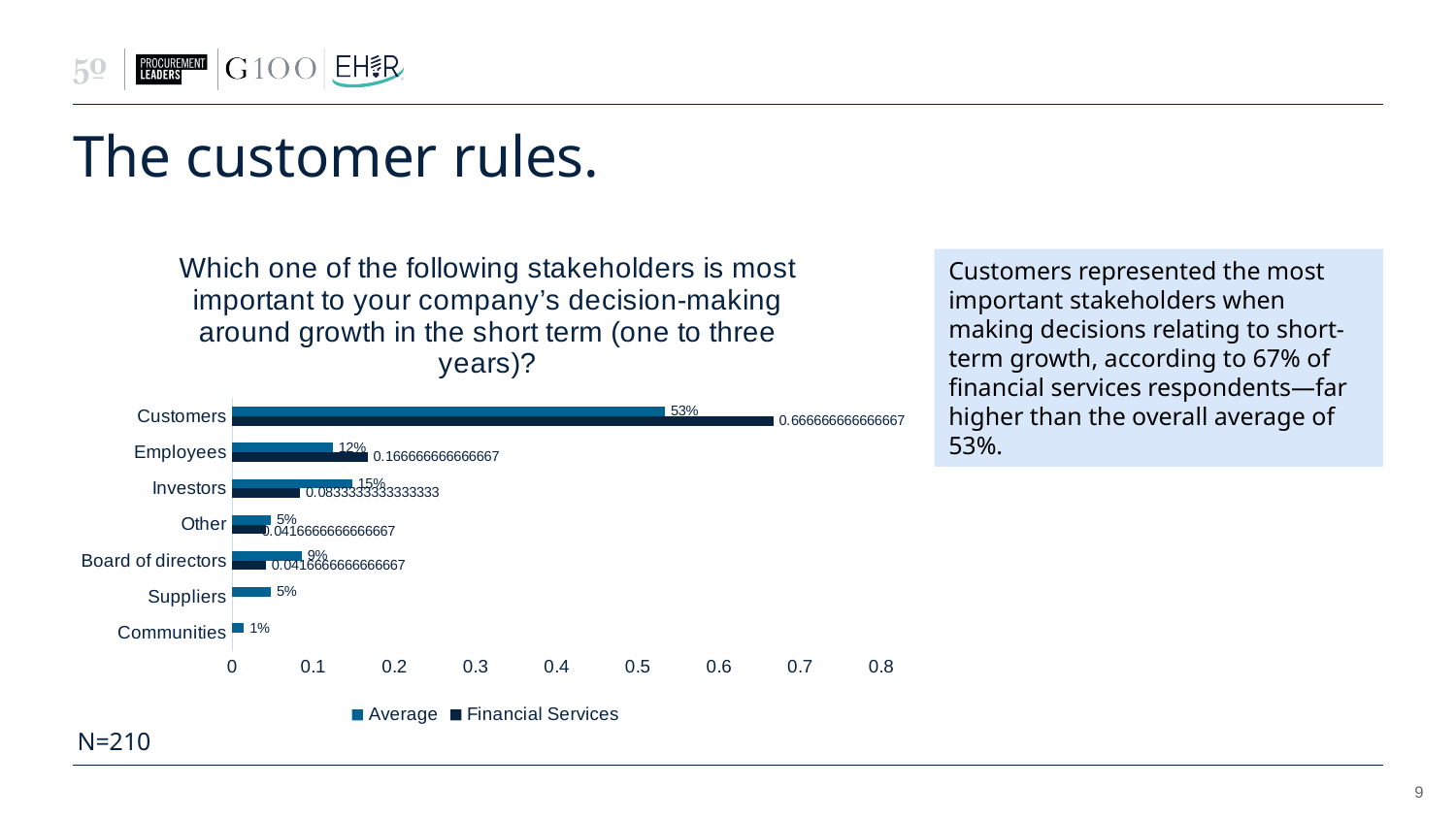
Which series is shown in the darker navy colour in the legend? Financial Services What is the Financial Services value for Customers? 0.666666666666667 Which stakeholder has the highest Average value? Customers Which is larger for Employees: the Average value or the Financial Services value? Financial Services What is the Average value for Customers? 53% What type of chart is shown on the slide? bar chart What is the difference between the Average values for Investors and Employees? 3% What is the Average value for Investors? 15% How many series does the chart legend list? 2 How many stakeholder categories are shown on the chart? 7 Which stakeholder has the lowest Average value? Communities What is the Financial Services value for Employees? 0.166666666666667